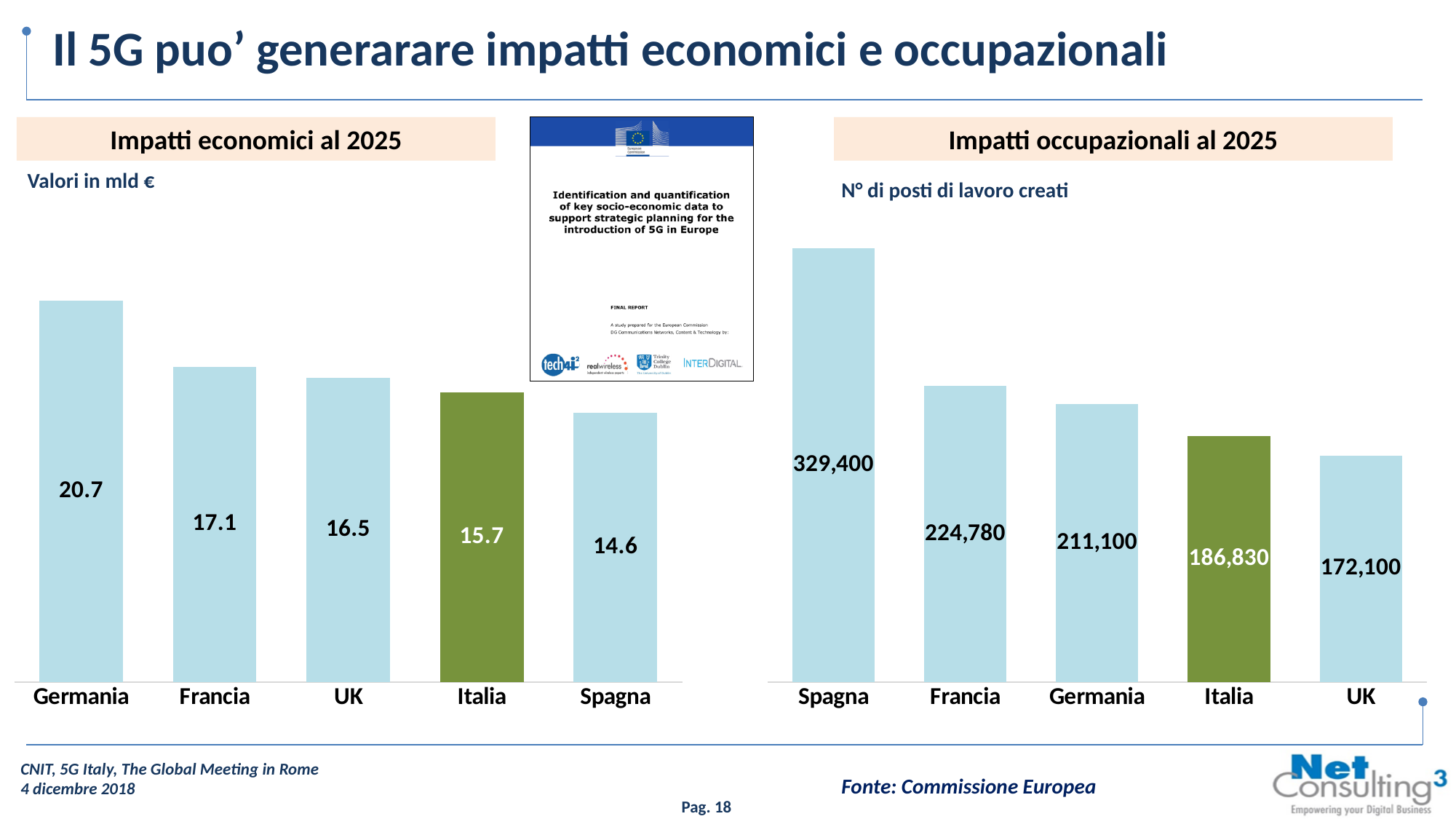
In the 'Impatti occupazionali al 2025' chart, which is larger, Francia or Germania? Francia In the 'Impatti economici al 2025' chart, what is the value for Italia? 15.7 In the 'Impatti occupazionali al 2025' chart, what is the value for Spagna? 329,400 In the 'Impatti occupazionali al 2025' chart, which country has the highest value? Spagna In the 'Impatti occupazionali al 2025' chart, what is the value for Italia? 186,830 In the 'Impatti economici al 2025' chart, which country has the lowest value? Spagna In the 'Impatti economici al 2025' chart, what is the value for Germania? 20.7 In the 'Impatti economici al 2025' chart, what unit are the values expressed in? mld € What type of chart is the 'Impatti occupazionali al 2025' chart? Bar chart In the 'Impatti occupazionali al 2025' chart, what is the difference between Spagna and UK? 157,300 In the 'Impatti economici al 2025' chart, what is the difference between Germania and Francia? 3.6 In the 'Impatti economici al 2025' chart, how many countries are shown? 5